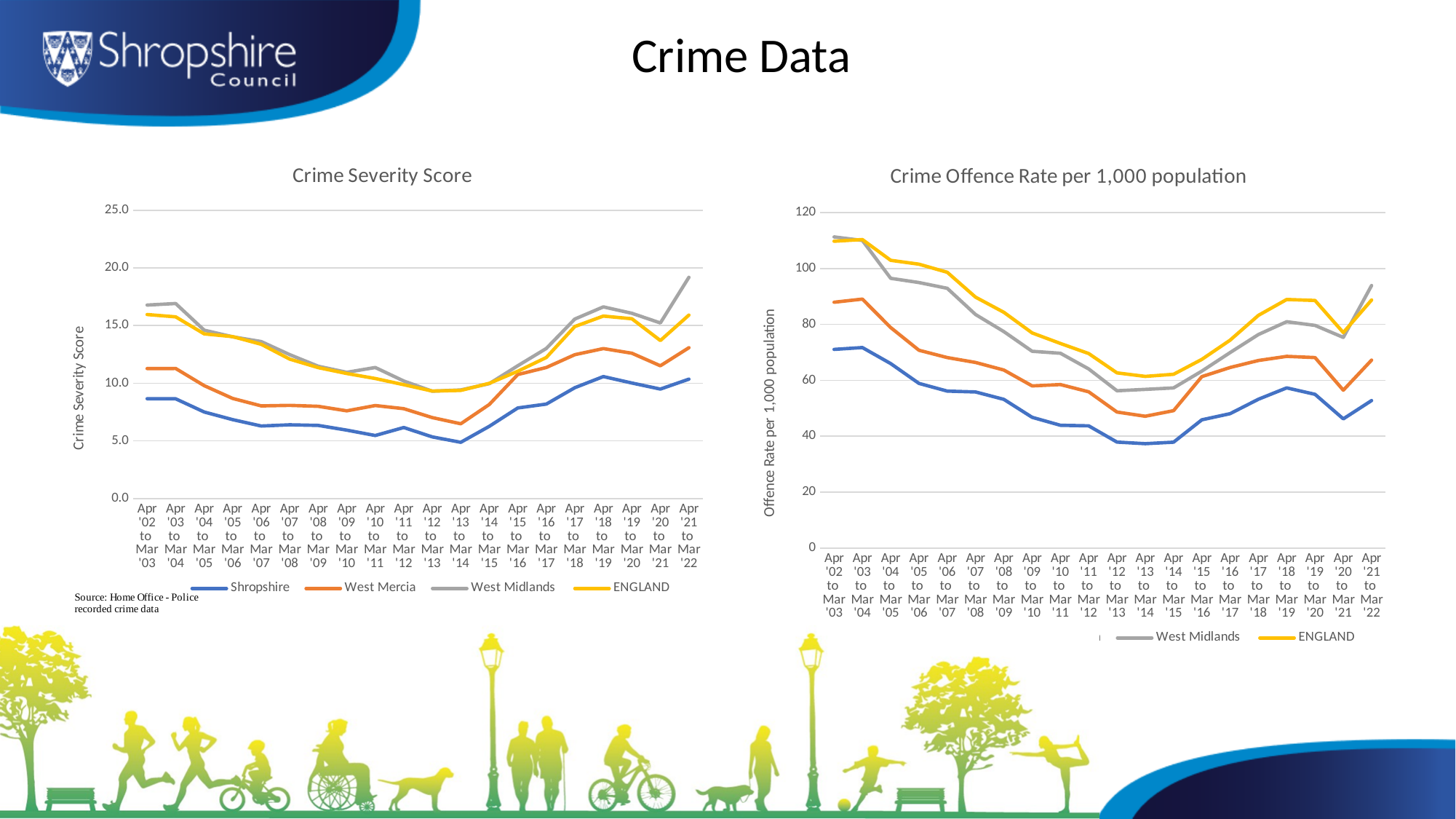
In the 'Crime Offence Rate per 1,000 population' chart, is the ENGLAND value for Apr '02 to Mar '03 greater or less than 100? greater In the 'Crime Severity Score' chart, does the Shropshire line rise or fall between Apr '02 to Mar '03 and Apr '13 to Mar '14? fall In the 'Crime Severity Score' chart, which series has the highest value in Apr '21 to Mar '22? West Midlands In the 'Crime Offence Rate per 1,000 population' chart, is the Shropshire (blue) value for Apr '13 to Mar '14 greater or less than 40? less How many series does the legend of the 'Crime Severity Score' chart list? 4 How many time periods are shown on the x axis of the 'Crime Severity Score' chart? 20 What is the y-axis label of the 'Crime Offence Rate per 1,000 population' chart? Offence Rate per 1,000 population In the 'Crime Severity Score' chart, is the West Midlands value for Apr '21 to Mar '22 greater or less than 15.0? greater In the 'Crime Severity Score' chart, which series has the lowest value in Apr '21 to Mar '22? Shropshire In the 'Crime Offence Rate per 1,000 population' chart, which is larger in Apr '21 to Mar '22: the West Midlands value or the ENGLAND value? West Midlands What kind of chart is the 'Crime Severity Score' chart? line chart